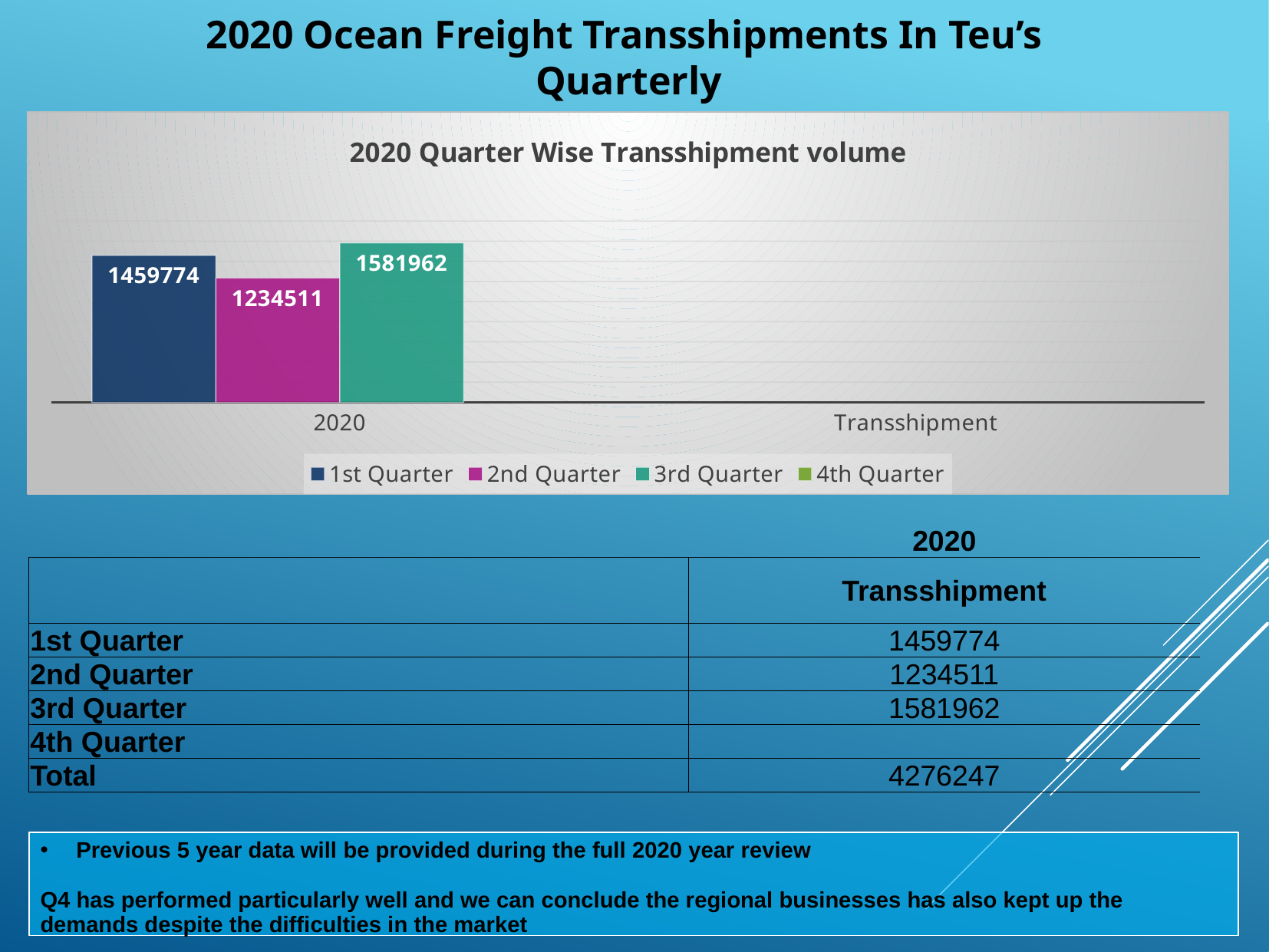
Which quarter has the highest bar in the chart? 3rd Quarter What is the value of the 1st Quarter bar in the chart? 1459774 What is the value of the 3rd Quarter bar in the chart? 1581962 How many series does the chart legend list? 4 Which quarter has the lowest bar in the chart? 2nd Quarter What is the title of the chart? 2020 Quarter Wise Transshipment volume What is the difference between the 3rd Quarter and 1st Quarter values in the chart? 122188 What type of chart is shown on the slide? bar chart Which legend entry has no bar plotted in the chart? 4th Quarter Is the 1st Quarter bar or the 2nd Quarter bar larger in the chart? 1st Quarter What is the difference between the 3rd Quarter and 2nd Quarter values in the chart? 347451 What is the value of the 2nd Quarter bar in the chart? 1234511